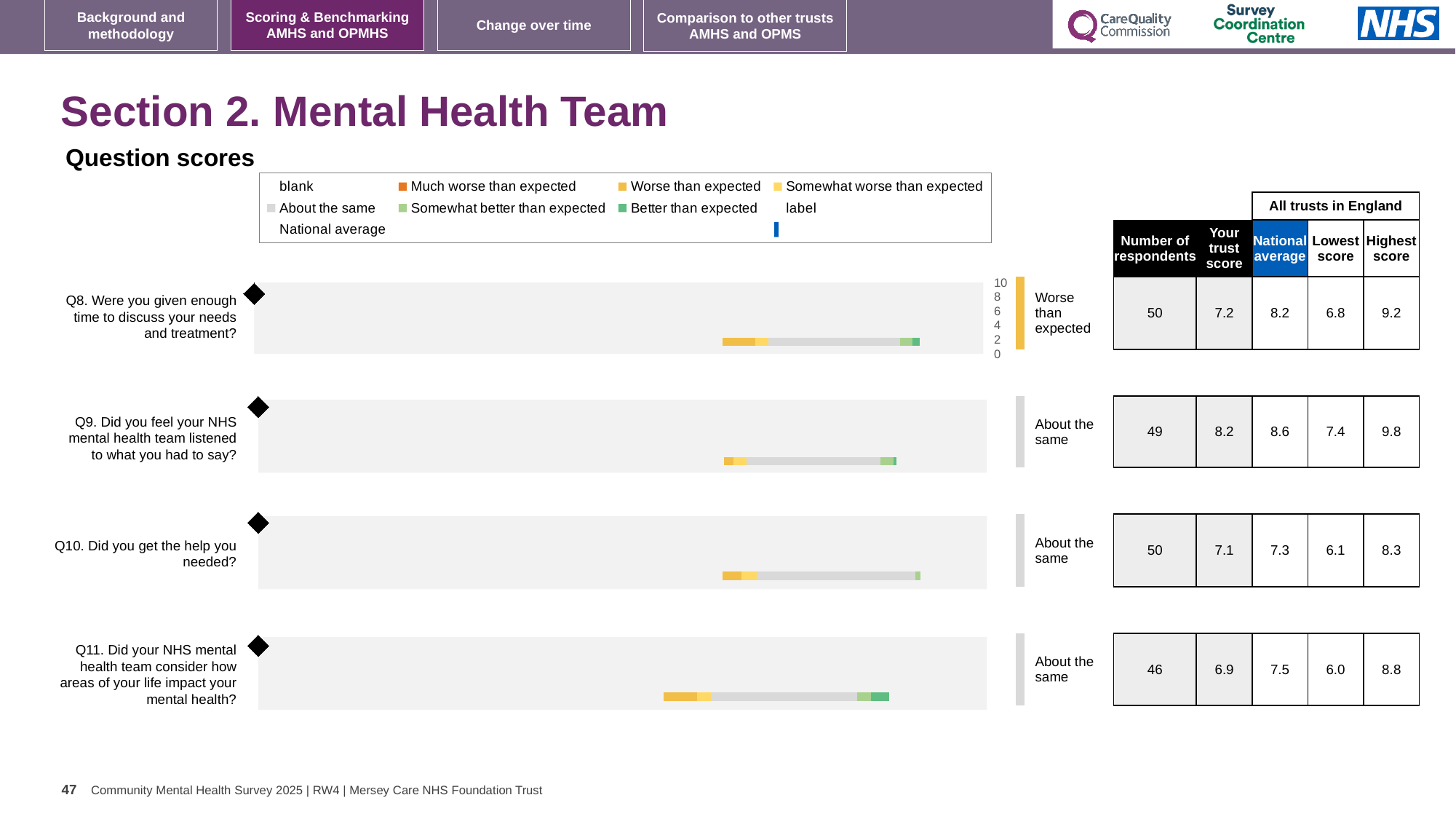
How many respondents answered Q11 (Did your NHS mental health team consider how areas of your life impact your mental health)? 46 What type of chart is used to show the question scores? bar chart How many questions are shown in the Question scores chart? 4 What benchmark category is shown for Q8? Worse than expected Which question has the lowest trust score? Q11 What is the national average for Q10 (Did you get the help you needed)? 7.3 What is the lowest score across all trusts in England for Q11? 6.0 What is the trust score for Q8 (Were you given enough time to discuss your needs and treatment)? 7.2 What is the difference between the national average and the trust score for Q8? 1.0 Is the trust score for Q10 higher or lower than the national average for Q10? lower Which question has the highest trust score? Q9 What is the highest score across all trusts in England for Q9 (Did you feel your NHS mental health team listened to what you had to say)? 9.8